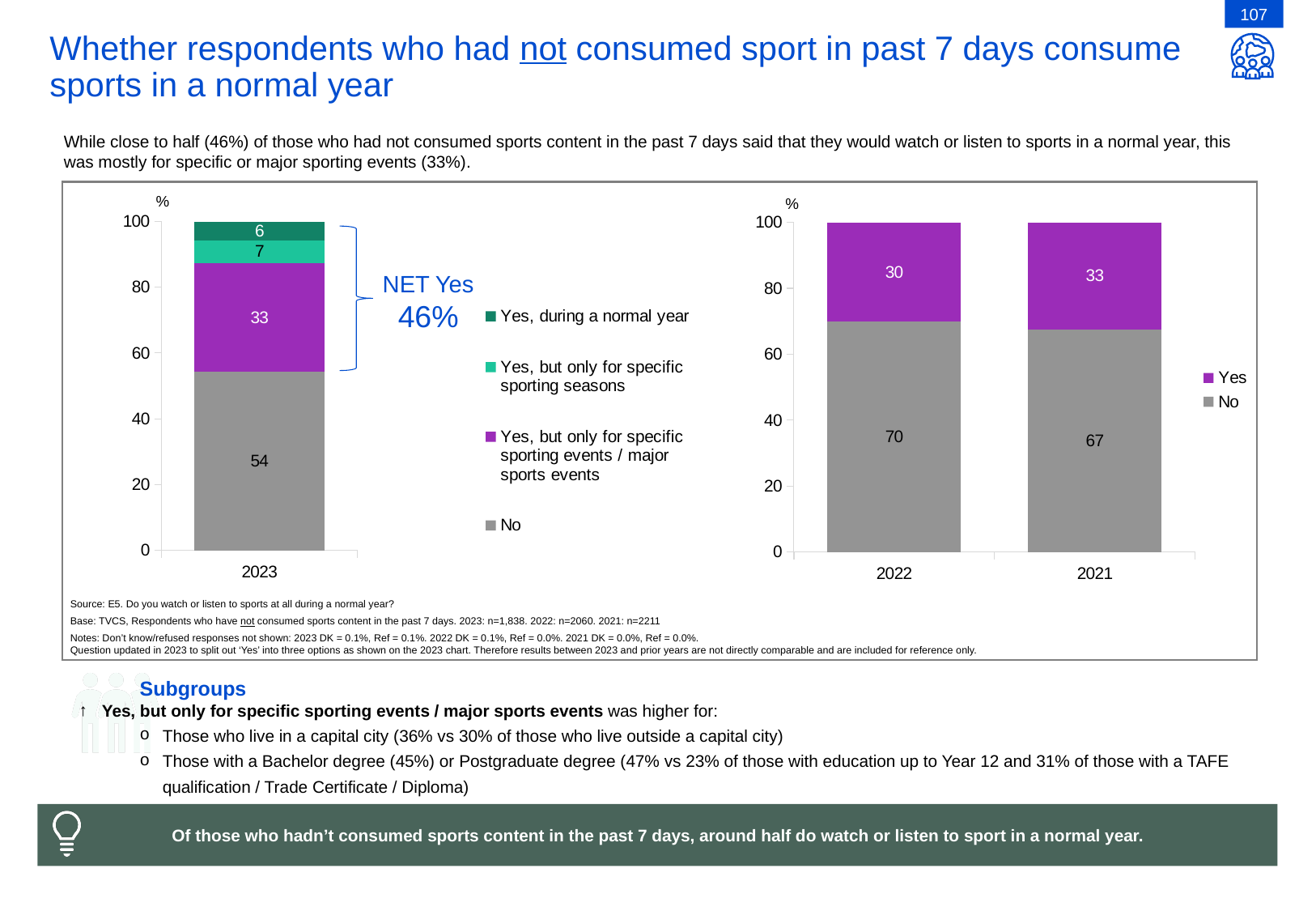
What type of chart is the right chart showing 2022 and 2021? Stacked bar chart In the left chart (2023), which response category has the smallest share? Yes, during a normal year In the right chart, what is the 'Yes' value for 2021? 33 In the left chart (2023), what is the value for 'Yes, but only for specific sporting seasons'? 7 In the right chart, what is the difference between the 'No' values for 2022 and 2021? 3 In the left chart (2023), which response category has the largest share? No How many series does the legend of the left chart (2023) list? 4 In the right chart, is the 'Yes' value larger in 2022 or 2021? 2021 In the right chart, what is the 'No' value for 2022? 70 In the left chart (2023), what is the value for 'Yes, during a normal year'? 6 In the left chart (2023), what percentage of respondents answered 'No'? 54 In the left chart (2023), what is the value for 'Yes, but only for specific sporting events / major sports events'? 33